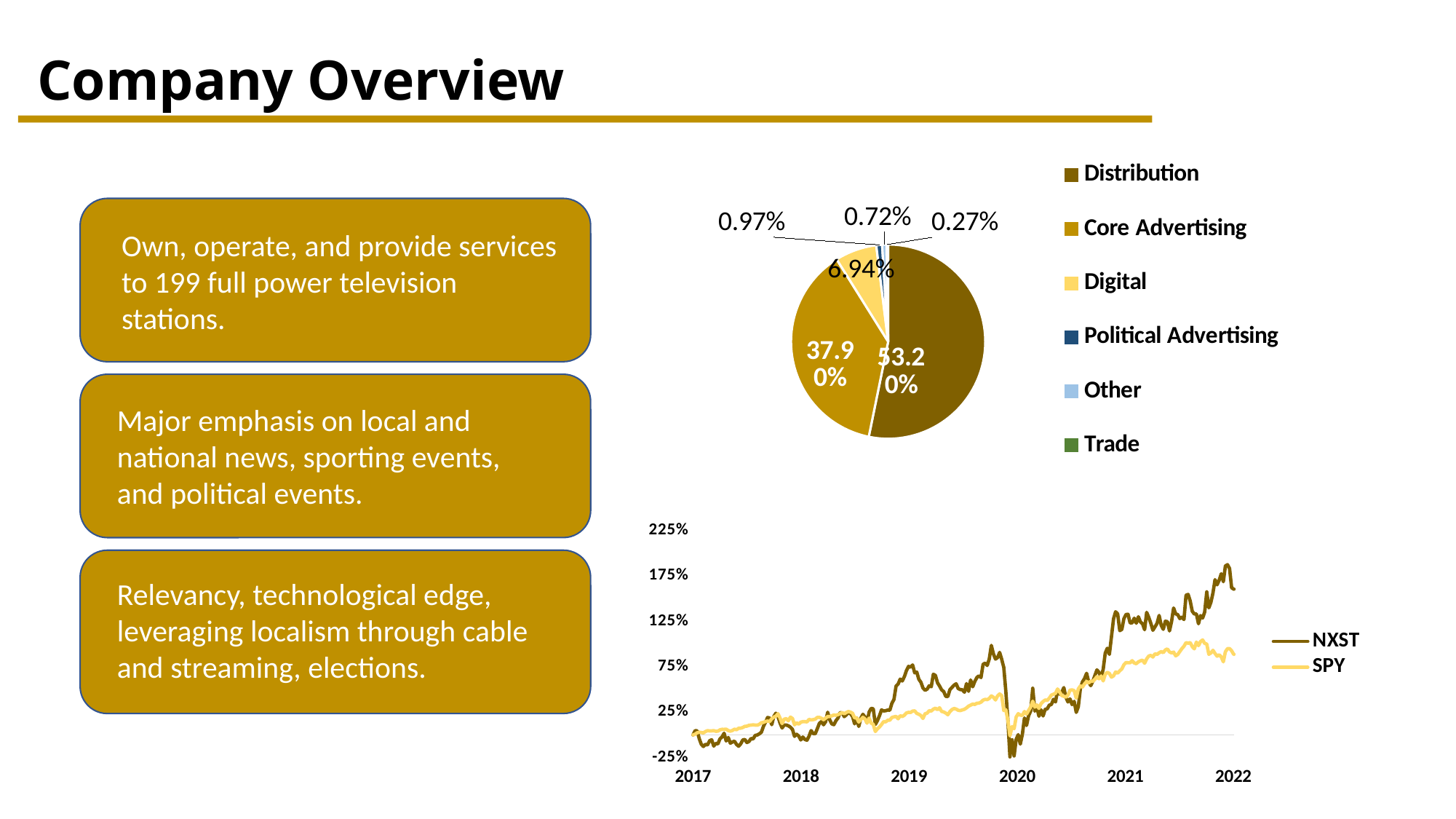
On the line chart at the bottom right, how many series does the legend list? 2 On the pie chart, how many categories does the legend list? 6 On the pie chart, what share does Distribution have? 53.20% On the line chart at the bottom right, which series is higher at 2022, NXST or SPY? NXST On the pie chart, what share does Digital have? 6.94% On the pie chart, how many percentage points larger is Distribution than Core Advertising? 15.30% What kind of chart is the chart at the top right of the slide? Pie chart What kind of chart is the chart at the bottom right of the slide? Line chart On the pie chart, what is the value of the smallest slice? 0.27% On the pie chart, what share does Core Advertising have? 37.90% On the pie chart, which category has the largest slice? Distribution